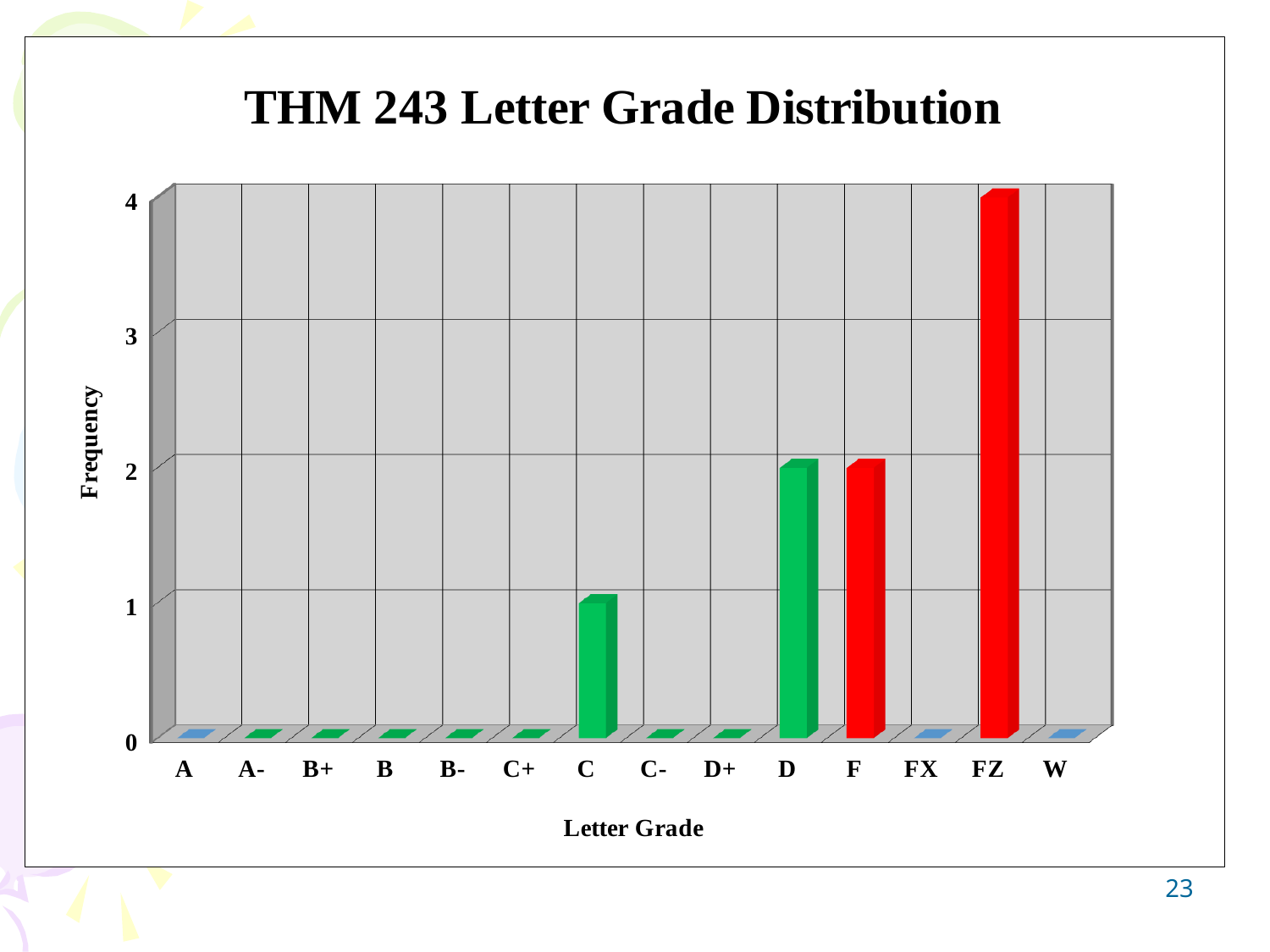
How many letter grade categories are shown on the x axis? 14 Which letter grade has the highest frequency? FZ What is the frequency for the C grade? 1 What is the title of the chart? THM 243 Letter Grade Distribution Which is larger, the frequency for D or the frequency for C? D Is the frequency for FZ greater or less than 3? greater What is the difference between the frequency for FZ and the frequency for F? 2 What is the frequency for the A grade? 0 What kind of chart is shown on the slide? bar chart What is the frequency for the FZ grade? 4 What is the frequency for the D grade? 2 What is the label of the y axis? Frequency